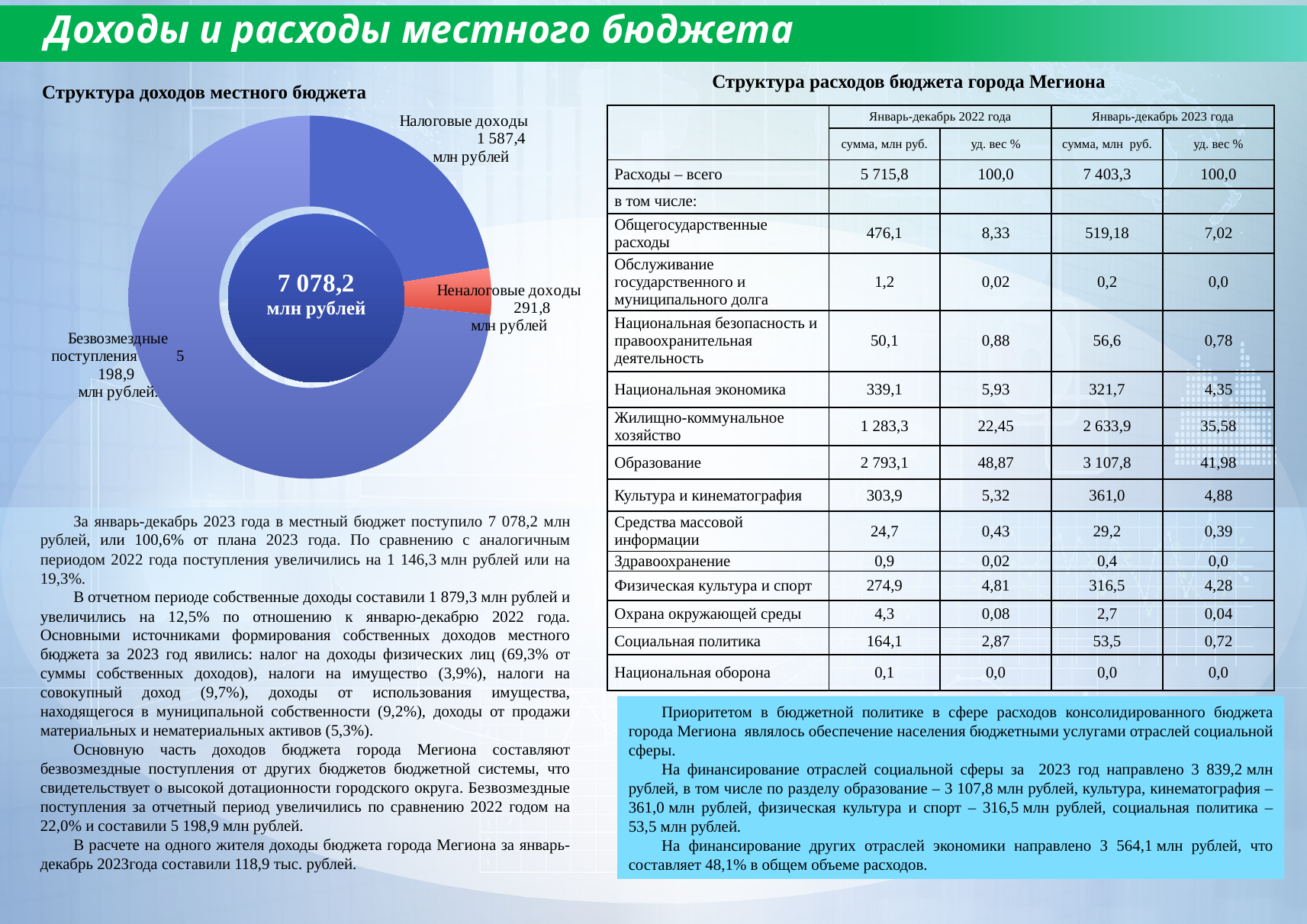
Which category has the largest slice in the donut chart? Безвозмездные поступления What total is printed in the centre of the donut chart? 7 078,2 млн рублей Which is larger in the donut chart: Налоговые доходы or Неналоговые доходы? Налоговые доходы What is the value shown for Неналоговые доходы in the donut chart? 291,8 млн рублей What kind of chart is used to show the structure of local budget revenues? Pie (donut) chart What is the title of the chart on the left of the slide? Структура доходов местного бюджета By how much do Безвозмездные поступления exceed Налоговые доходы in the donut chart, in млн рублей? 3 611,5 How many categories are shown in the donut chart? 3 By how much do Налоговые доходы exceed Неналоговые доходы in the donut chart, in млн рублей? 1 295,6 What is the value shown for Безвозмездные поступления in the donut chart? 5 198,9 млн рублей What is the value shown for Налоговые доходы in the donut chart? 1 587,4 млн рублей Which category has the smallest slice in the donut chart? Неналоговые доходы